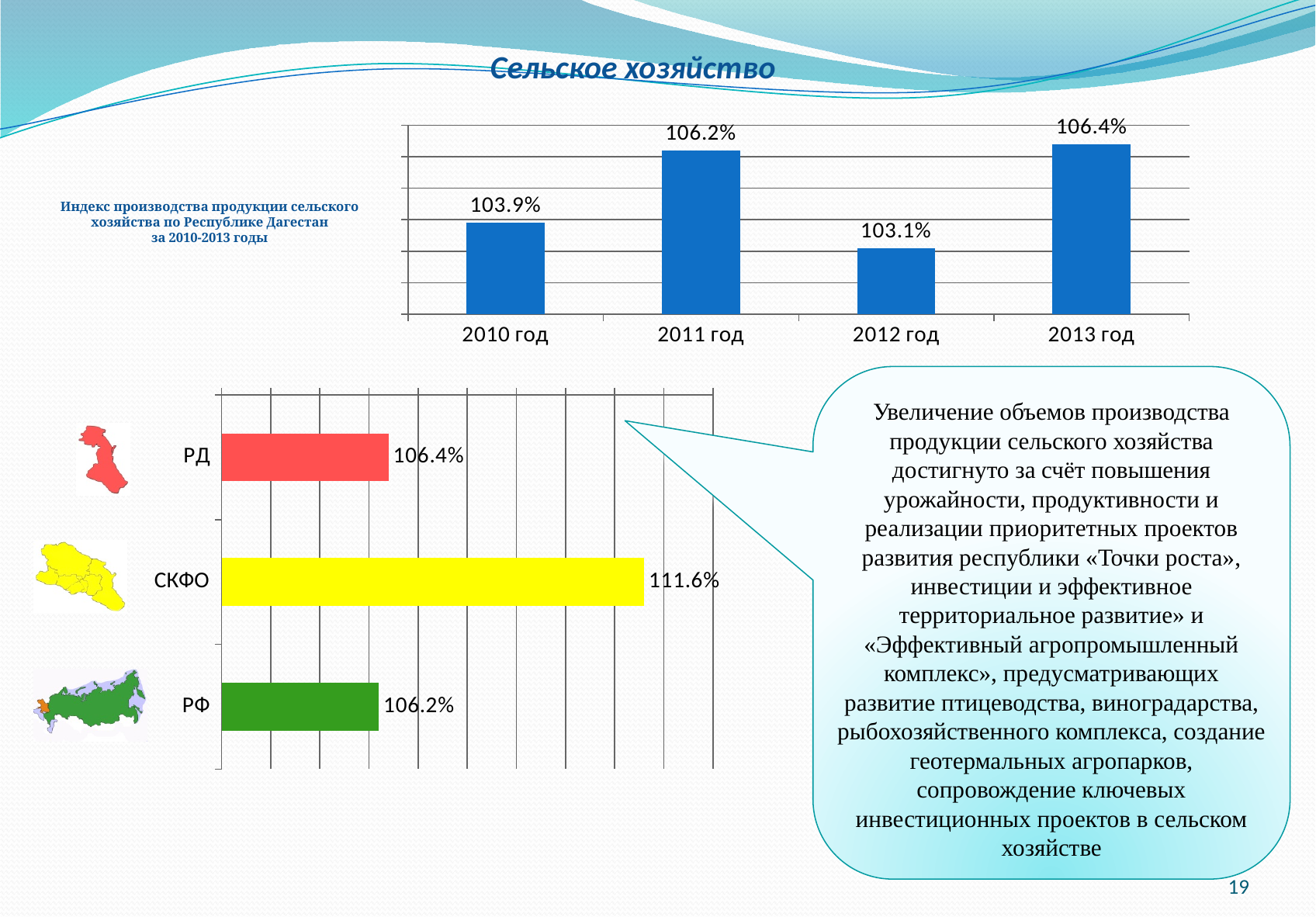
In the bottom chart, what is the value for СКФО? 111.6% In the top chart, does the value rise or fall from 2011 год to 2012 год? fall In the top chart, what is the difference between the values for 2013 год and 2010 год? 2.5% In the top chart, which year has the highest value? 2013 год In the bottom chart, what is the difference between the values for СКФО and РД? 5.2% In the bottom chart, which category has the highest value? СКФО In the bottom chart, what is the value for РФ? 106.2% In the top chart (Индекс производства продукции сельского хозяйства по Республике Дагестан за 2010-2013 годы), what is the value for 2011 год? 106.2% In the top chart, which year has the lowest value? 2012 год In the top chart, how many years are plotted? 4 What type of chart is the bottom chart? bar chart In the top chart, what is the value for 2012 год? 103.1%